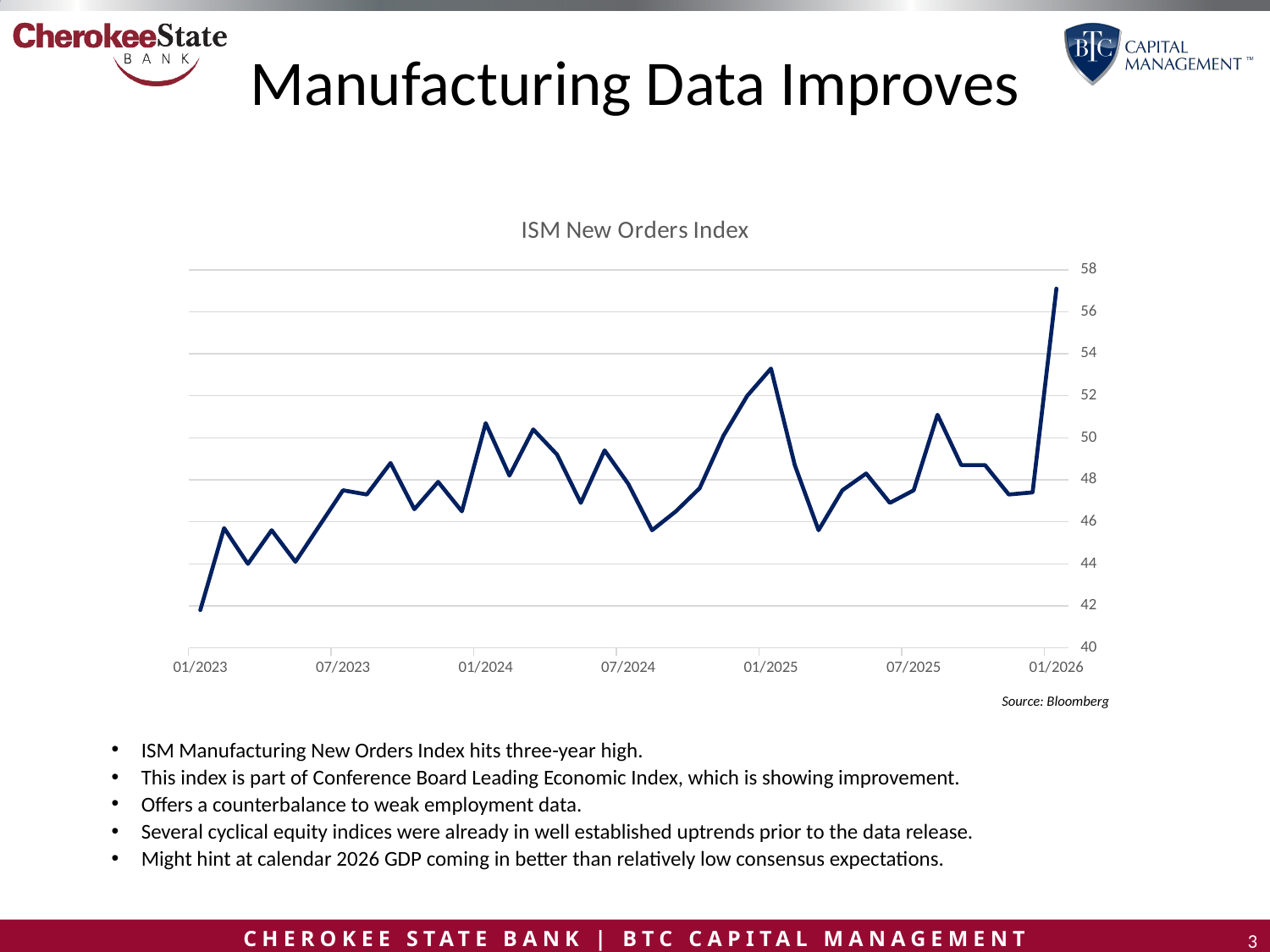
Is the value for 01/2025 greater or less than 52? greater Is the value for 01/2026 greater or less than 54? greater At which date on the x axis does the ISM New Orders Index reach its lowest value? 01/2023 What source is cited below the chart? Bloomberg Is the value for 01/2023 greater or less than 44? less What kind of chart is shown on the slide? line chart At which date on the x axis does the ISM New Orders Index reach its highest value? 01/2026 Overall, does the ISM New Orders Index rise or fall from 01/2023 to 01/2026? rise Which is larger, the value at 01/2025 or the value at 01/2026? 01/2026 How many date labels are shown on the x axis? 7 What is the title of the chart? ISM New Orders Index